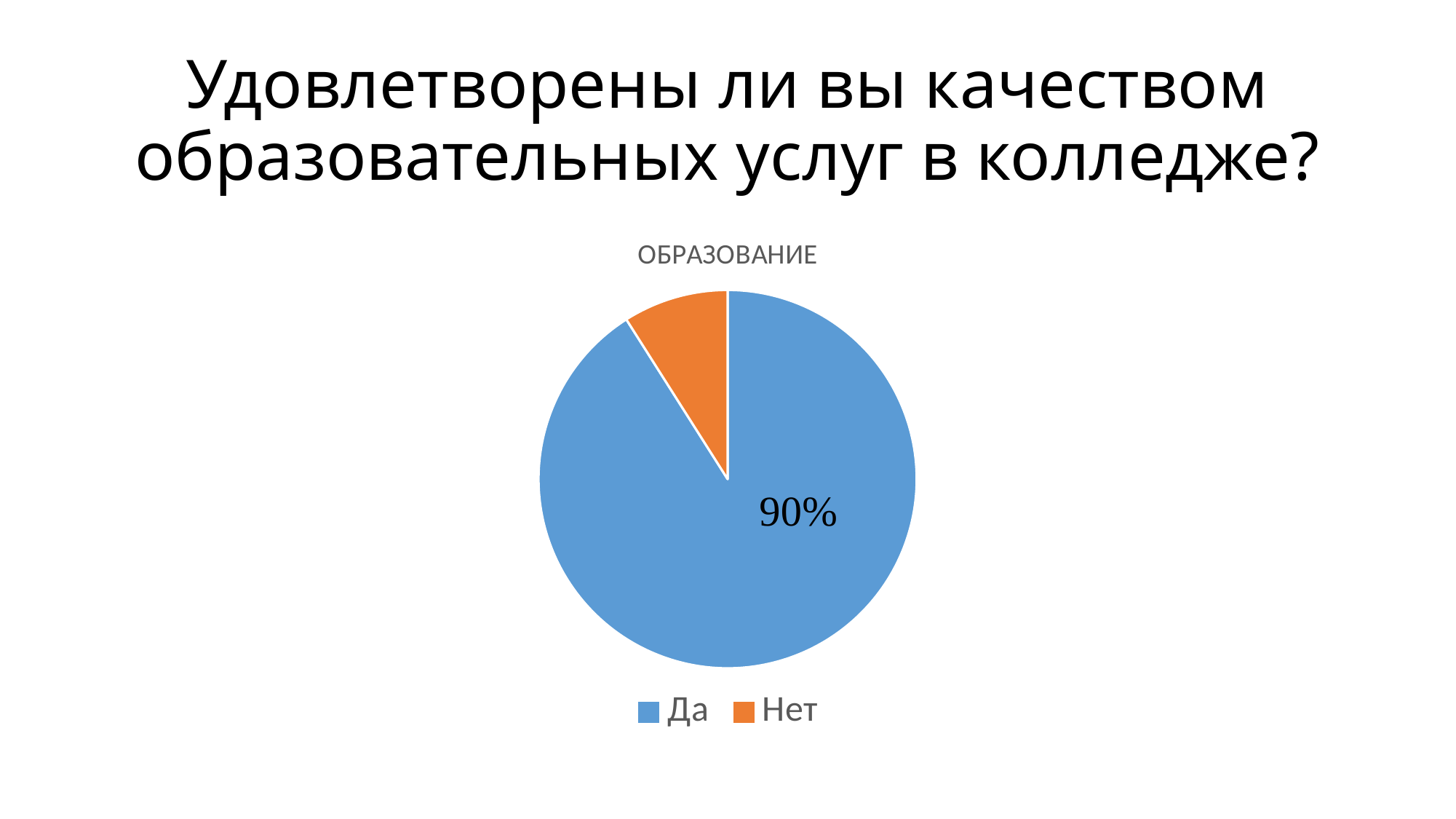
What is the title of the chart? ОБРАЗОВАНИЕ Which slice is larger, "Да" or "Нет"? Да How many slices does the pie chart have? 2 What is the value shown for the "Да" slice? 90% How many entries does the legend list? 2 What share of the pie does the "Да" slice represent? 90% Which category has the smallest slice of the pie? Нет What kind of chart is shown on the slide? pie chart What colour is the "Нет" slice? orange Which category has the largest slice of the pie? Да